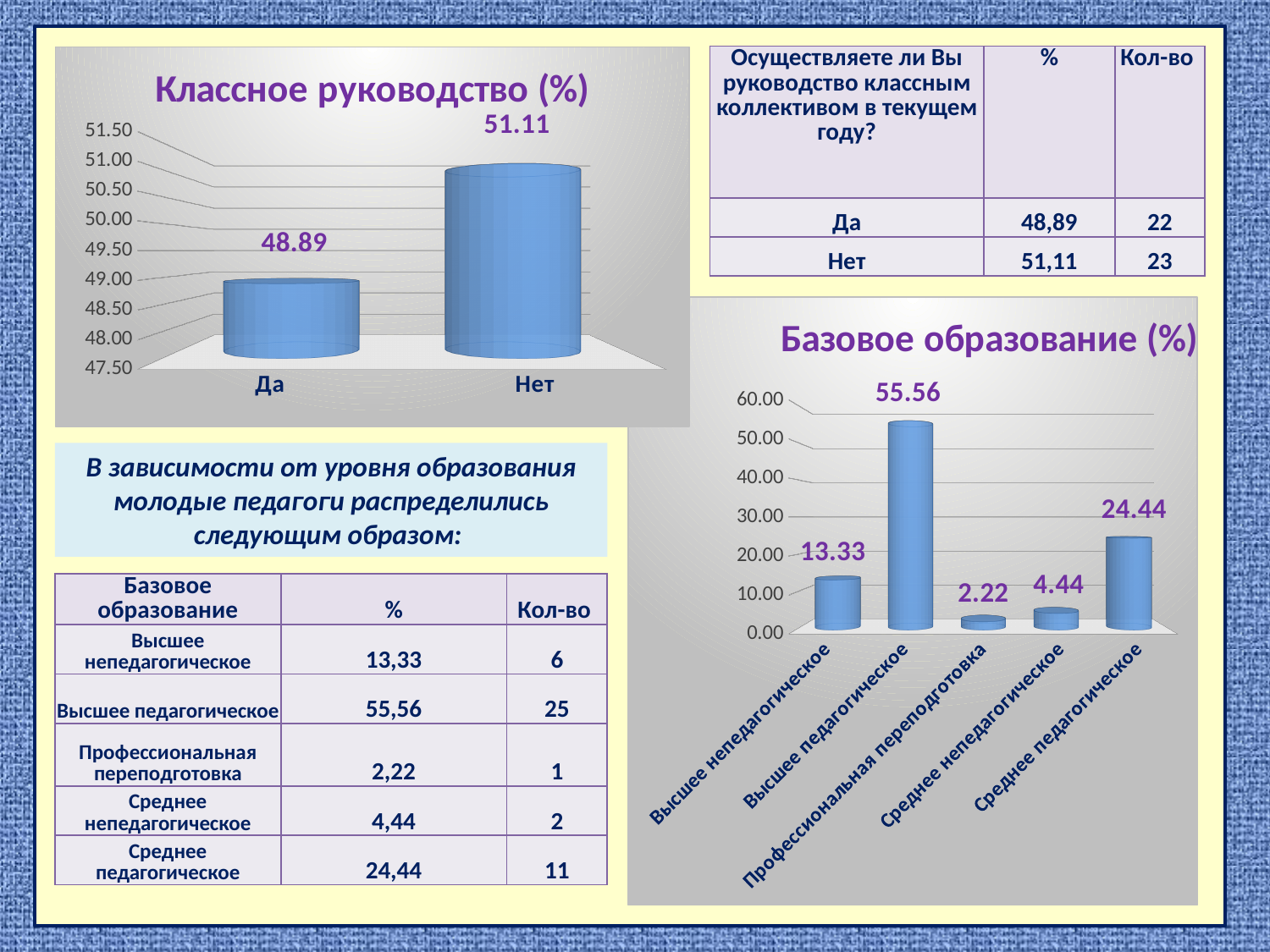
In the chart titled "Классное руководство (%)", which category has the higher value? Нет In the chart titled "Классное руководство (%)", what is the value for "Нет"? 51.11 In the chart titled "Классное руководство (%)", what is the difference between the values for "Нет" and "Да"? 2.22 In the chart titled "Базовое образование (%)", which category has the lowest value? Профессиональная переподготовка What kind of chart is the chart titled "Базовое образование (%)"? Bar chart In the chart titled "Базовое образование (%)", how many categories are plotted? 5 In the chart titled "Базовое образование (%)", what is the value for "Высшее педагогическое"? 55.56 In the chart titled "Базовое образование (%)", what is the value for "Среднее педагогическое"? 24.44 In the chart titled "Классное руководство (%)", how many categories are plotted? 2 In the chart titled "Классное руководство (%)", what is the value for "Да"? 48.89 In the chart titled "Базовое образование (%)", what is the difference between the values for "Высшее педагогическое" and "Среднее педагогическое"? 31.12 In the chart titled "Базовое образование (%)", which category has the highest value? Высшее педагогическое